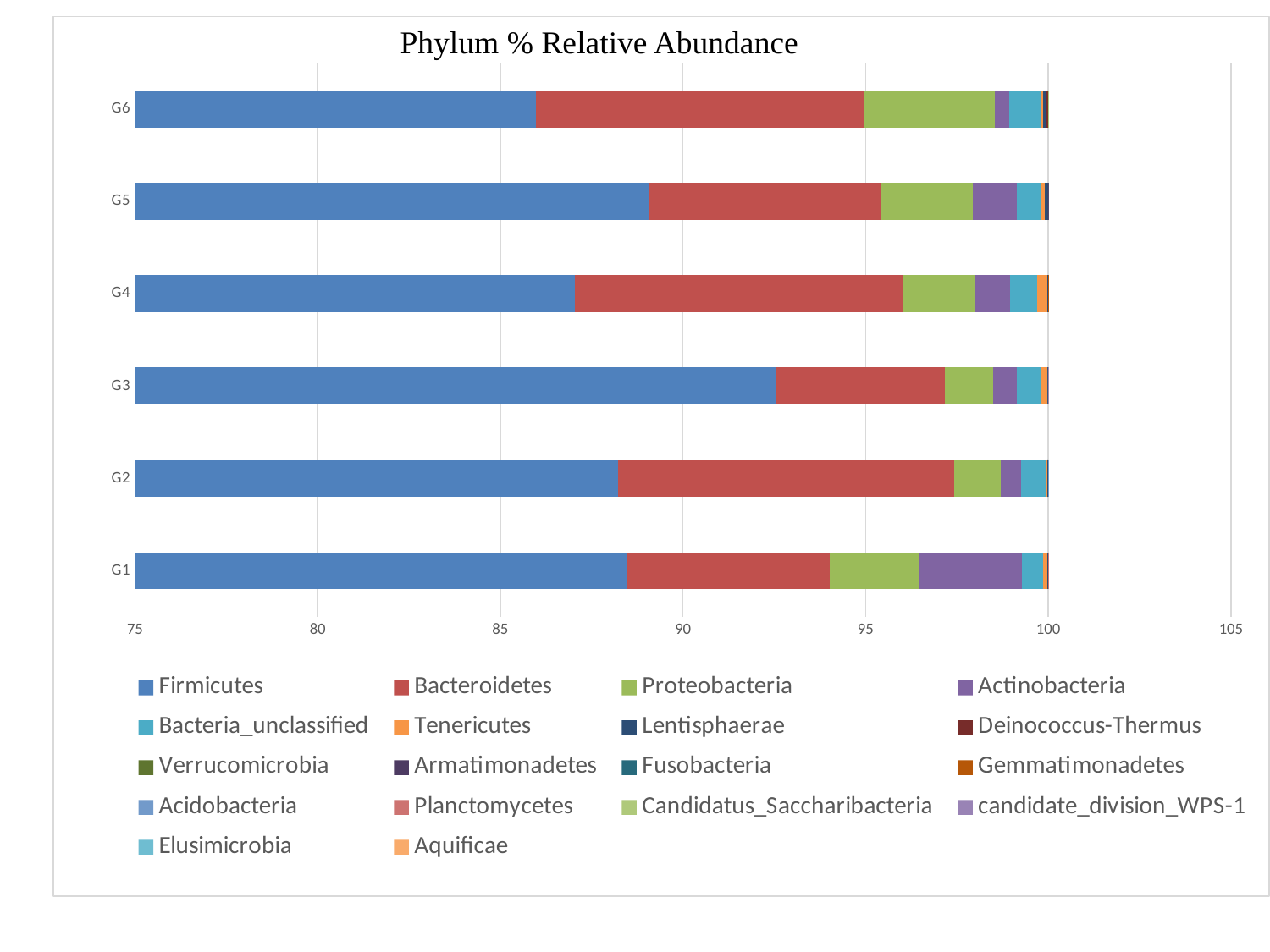
Which group has the smallest Firmicutes segment? G6 How many series does the legend list? 18 Which group has the smallest Bacteroidetes segment? G3 What is the title of the chart? Phylum % Relative Abundance Is the Firmicutes value for G3 greater or less than 90? greater Is the Firmicutes value for G6 greater or less than 90? less What kind of chart is shown on the slide? Stacked bar chart At what value does the horizontal axis start? 75 Which group has the largest Firmicutes segment? G3 Which is larger, the Firmicutes value for G3 or for G6? G3 Which group has the largest Actinobacteria segment? G1 How many groups (categories) are plotted on the vertical axis? 6